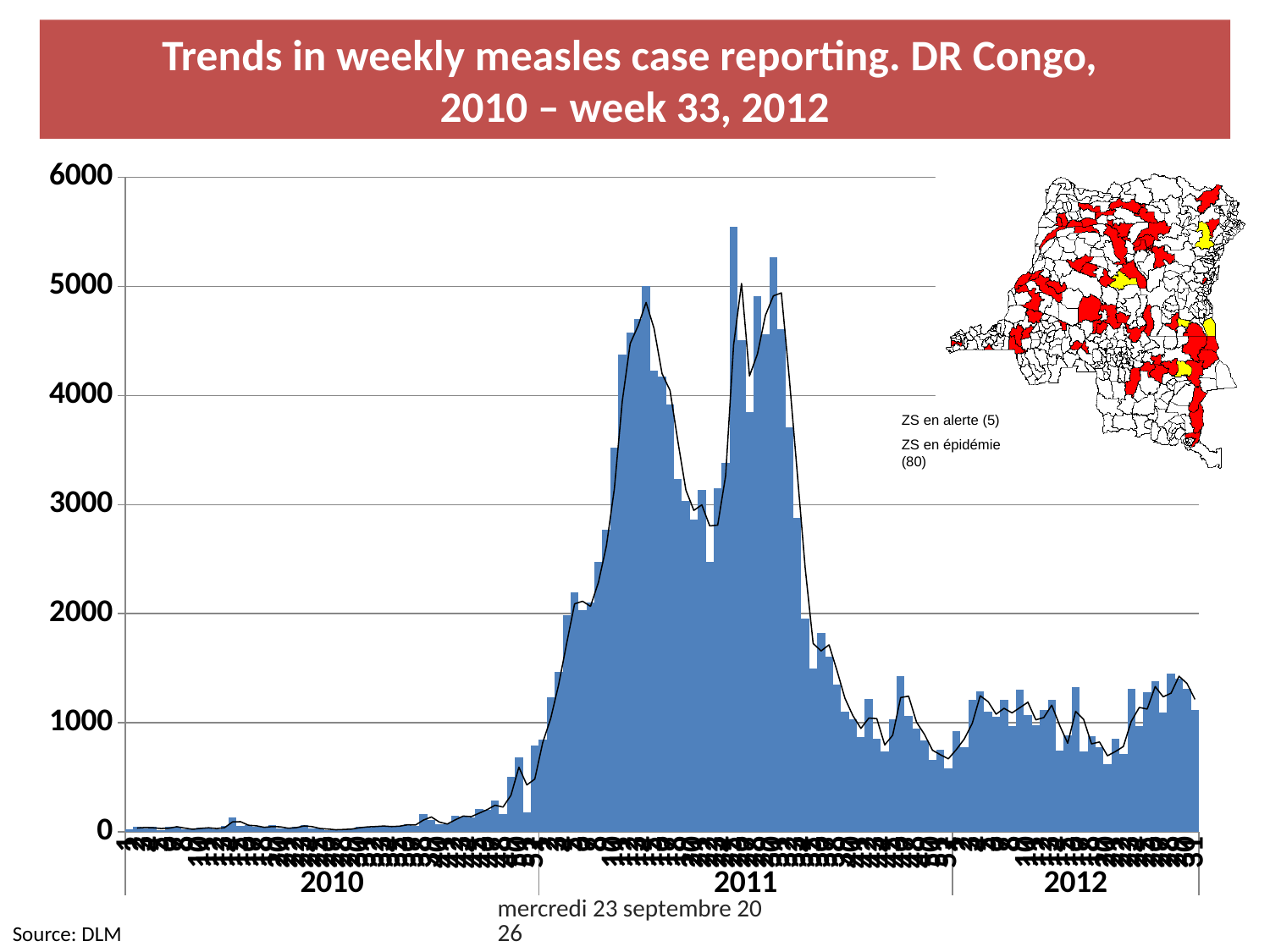
Do the weekly case counts rise or fall from the start of 2010 to the middle of 2011? rise How many years are labelled along the x axis of the chart? 3 Is the highest weekly bar in 2011 greater or less than 5000? greater Which year has the higher peak of weekly cases, 2010 or 2011? 2011 What kind of chart is used to show the weekly measles cases? Bar chart with a line overlay What is the title of the chart on the slide? Trends in weekly measles case reporting. DR Congo, 2010 – week 33, 2012 Are the weekly bars at the start of 2010 greater or less than 1000? less Do the weekly case counts rise or fall from the 2011 peak to the start of 2012? fall According to the map legend, how many health zones (ZS) are in epidemic (en épidémie)? 80 Is the highest weekly bar in 2012 greater or less than 2000? less Which year contains the highest weekly bar in the chart? 2011